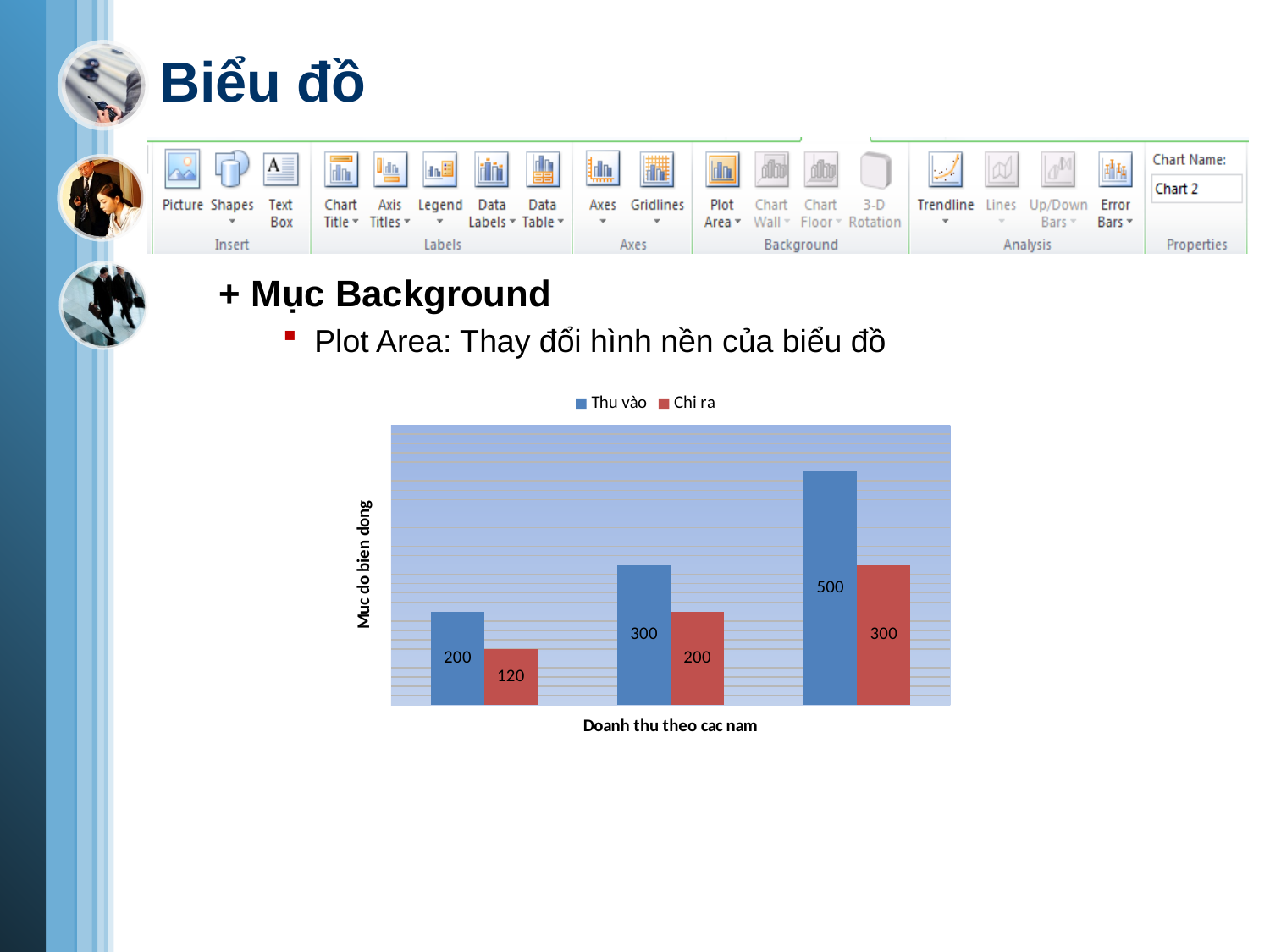
Which group has the highest Thu vào value? the third group How many series does the chart legend list? 2 Do the Thu vào values rise or fall from left to right across the groups? rise What is the value of the Chi ra bar in the second group? 200 What is the value of the Thu vào bar in the third group? 500 What is the title of the horizontal axis of the chart? Doanh thu theo cac nam What is the value of the Thu vào bar in the first group? 200 What kind of chart is shown on the slide? bar chart What is the lowest Chi ra value shown in the chart? 120 What is the value of the Chi ra bar in the first group? 120 What is the difference between Thu vào and Chi ra in the third group? 200 How many groups of bars are plotted in the chart? 3